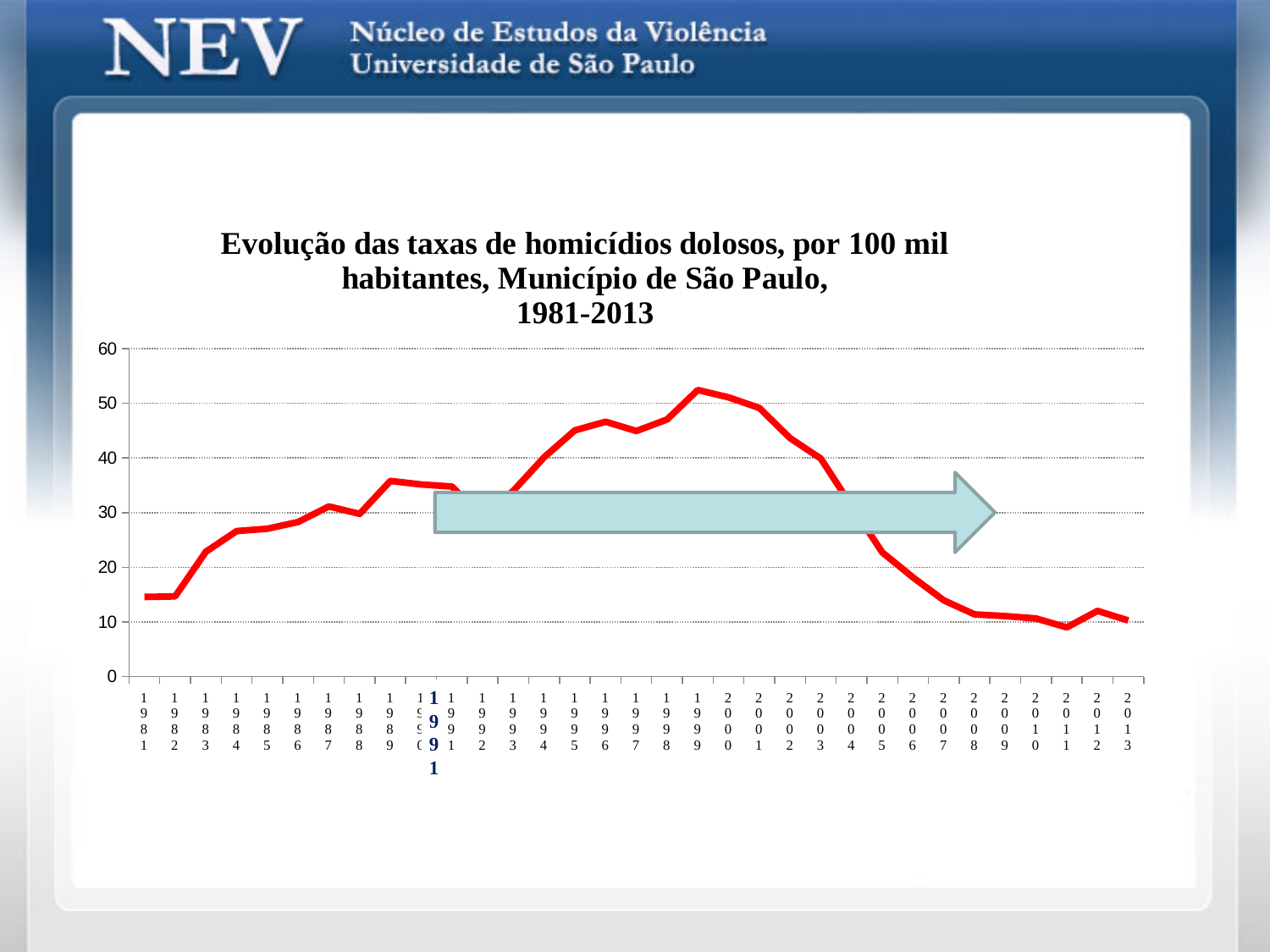
Is the value for 2008 greater or less than 20? less What is the title of the chart? Evolução das taxas de homicídios dolosos, por 100 mil habitantes, Município de São Paulo, 1981-2013 In which year does the homicide rate reach its highest value? 1999 Do the values rise or fall from 1981 to 1989? rise Is the value for 1995 greater or less than 40? greater Is the value for 1999 greater or less than 50? greater What kind of chart is shown on the slide? line chart How many years (data points) are plotted along the x axis? 33 In which year is the homicide rate at its lowest? 2011 Do the values rise or fall from 1999 to 2013? fall Which year has the higher homicide rate, 1999 or 2013? 1999